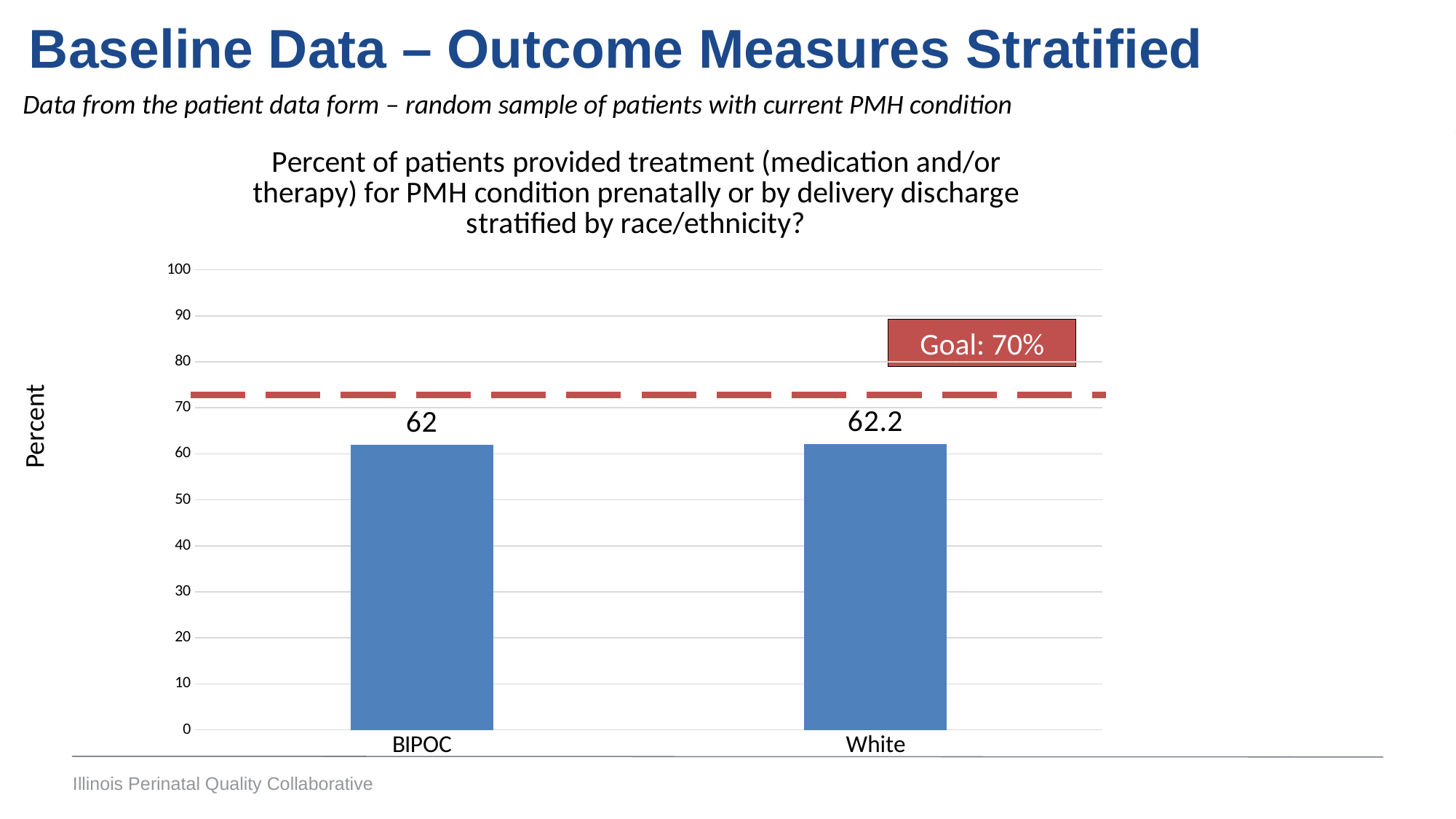
What is the label of the y axis? Percent Is the value for White greater or less than 60? greater Is the value for BIPOC greater or less than 70? less Is the value for BIPOC greater or less than 50? greater What is the difference between the values for White and BIPOC? 0.2 How many categories are shown on the x axis? 2 What is the value for White? 62.2 What kind of chart is shown on the slide? bar chart What is the value for BIPOC? 62 What goal value is marked by the dashed line on the chart? 70%